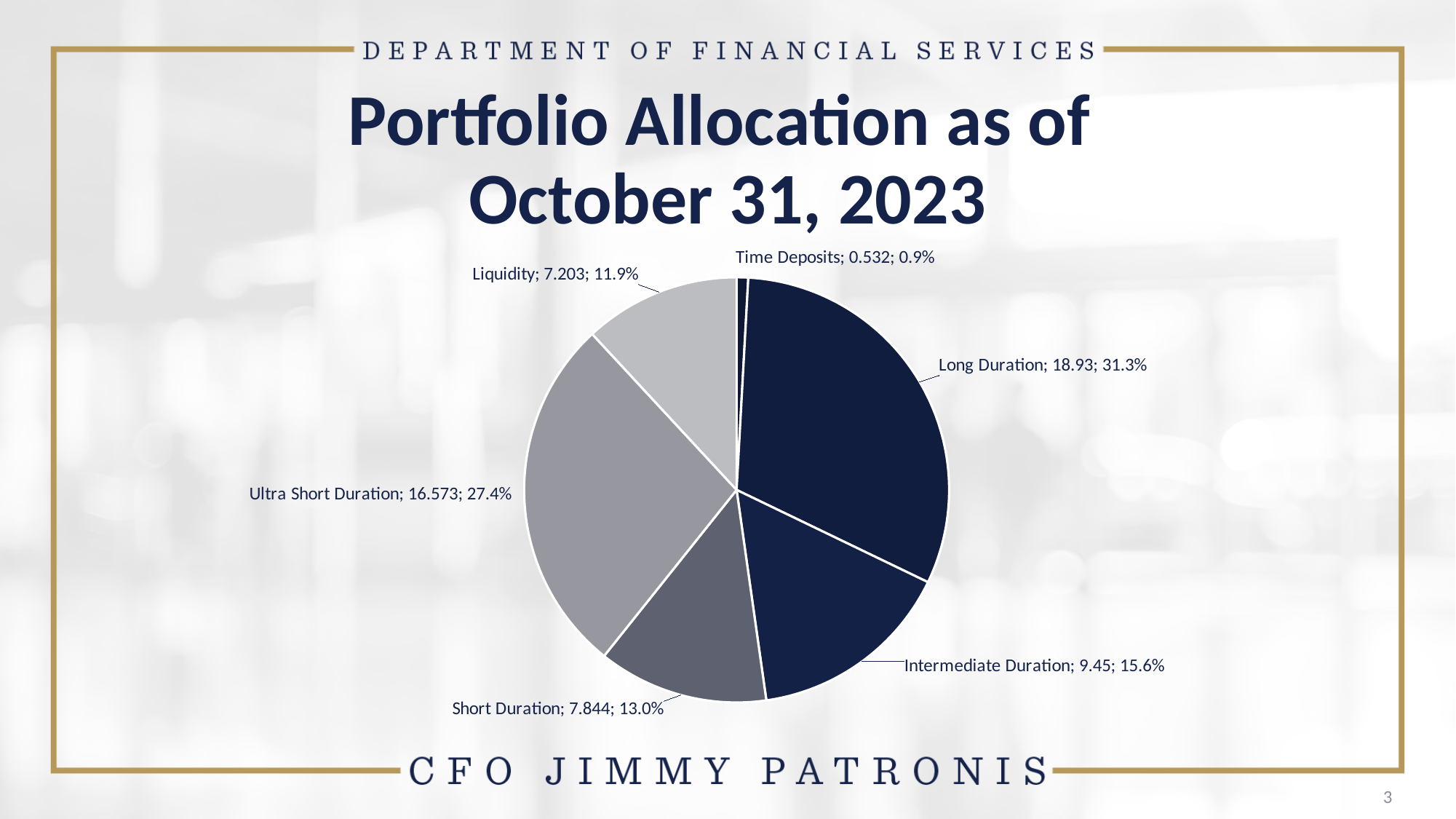
What is the value for Long Duration? 18.93 What is the value for Liquidity? 7.203 Which category has the smallest slice? Time Deposits What percentage share does Time Deposits have? 0.9% Which is larger, Short Duration or Intermediate Duration? Intermediate Duration What is the difference in percentage share between Long Duration and Ultra Short Duration? 3.9% What type of chart is shown on the slide? Pie chart What is the title of the chart? Portfolio Allocation as of October 31, 2023 What percentage share does Ultra Short Duration have? 27.4% How many categories are shown in the pie chart? 6 What is the value for Short Duration? 7.844 Which category has the largest slice? Long Duration